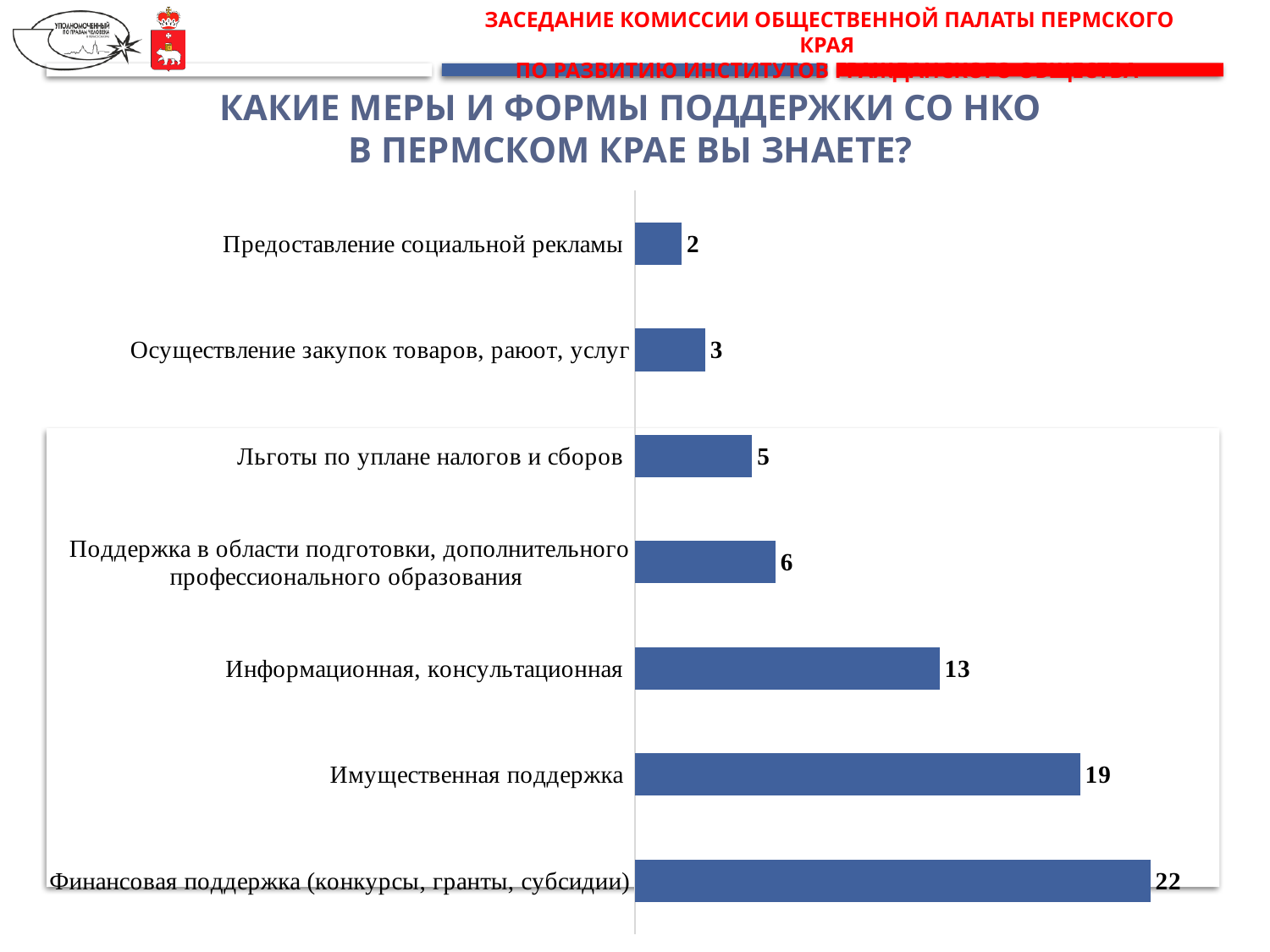
Which category has the highest value? Финансовая поддержка (конкурсы, гранты, субсидии) What is the title of the chart on the slide? КАКИЕ МЕРЫ И ФОРМЫ ПОДДЕРЖКИ СО НКО В ПЕРМСКОМ КРАЕ ВЫ ЗНАЕТЕ? What kind of chart is shown on the slide? Bar chart What is the difference between the values for Финансовая поддержка (конкурсы, гранты, субсидии) and Имущественная поддержка? 3 What is the value for Льготы по уплане налогов и сборов? 5 What is the value for Информационная, консультационная? 13 Which category has the lowest value? Предоставление социальной рекламы What is the difference between the values for Информационная, консультационная and Поддержка в области подготовки, дополнительного профессионального образования? 7 How many categories are shown in the chart? 7 What is the value for Предоставление социальной рекламы? 2 What is the value for Финансовая поддержка (конкурсы, гранты, субсидии)? 22 Which is larger: the value for Имущественная поддержка or the value for Информационная, консультационная? Имущественная поддержка